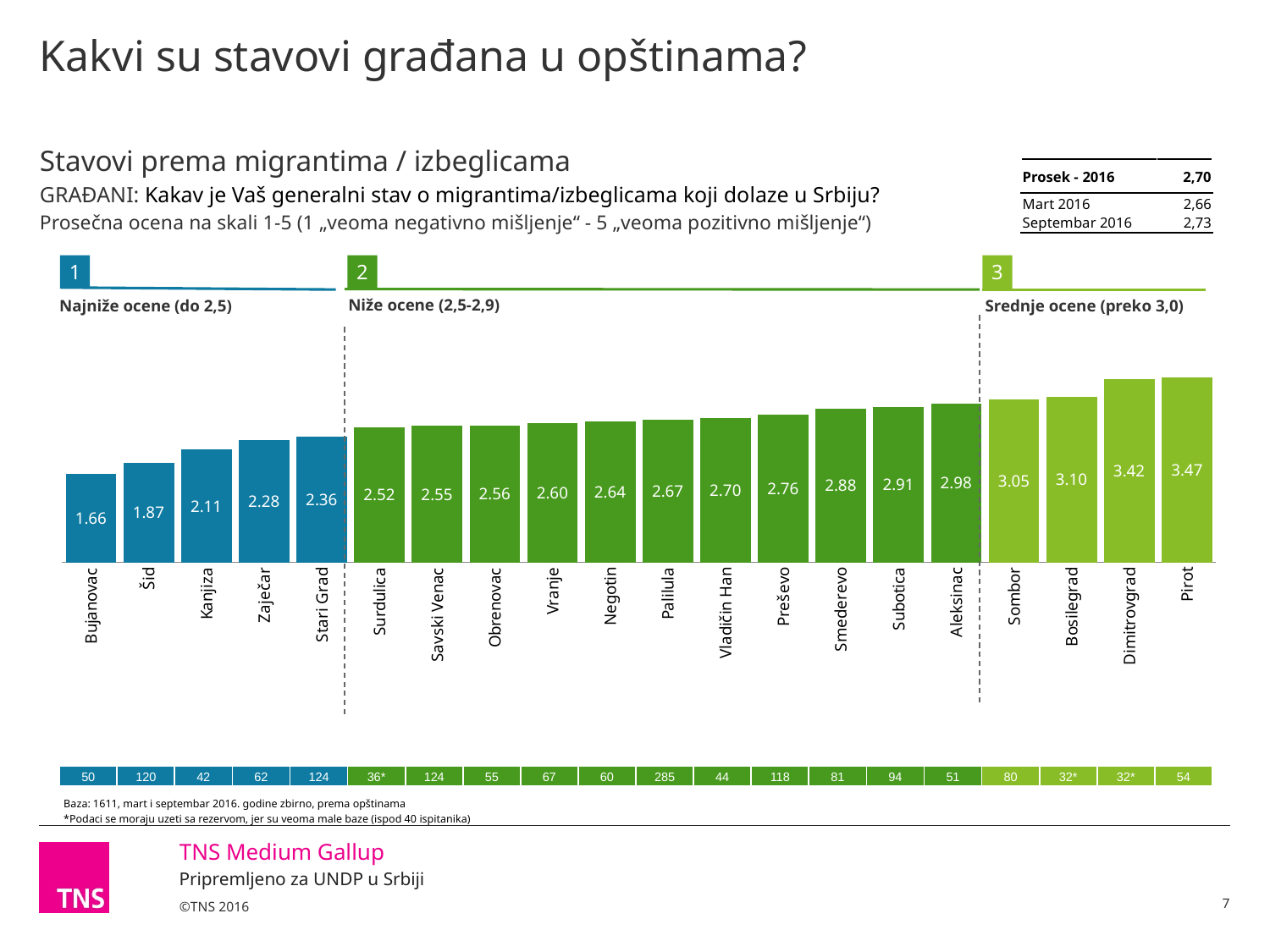
What is the difference between the scores for Subotica and Surdulica? 0.39 Which has a higher average score, Sombor or Aleksinac? Sombor Which municipality has the highest average score? Pirot What is the average score for Bujanovac? 1.66 What is the difference between the scores for Pirot and Bujanovac? 1.81 What kind of chart is shown on the slide? Bar chart Which municipality has the lowest average score? Bujanovac What is the average score for Dimitrovgrad? 3.42 How many municipalities are shown in the chart? 20 What is the average score for Smederevo? 2.88 Do the scores rise or fall from left to right across the chart? Rise Which has a higher average score, Šid or Zaječar? Zaječar